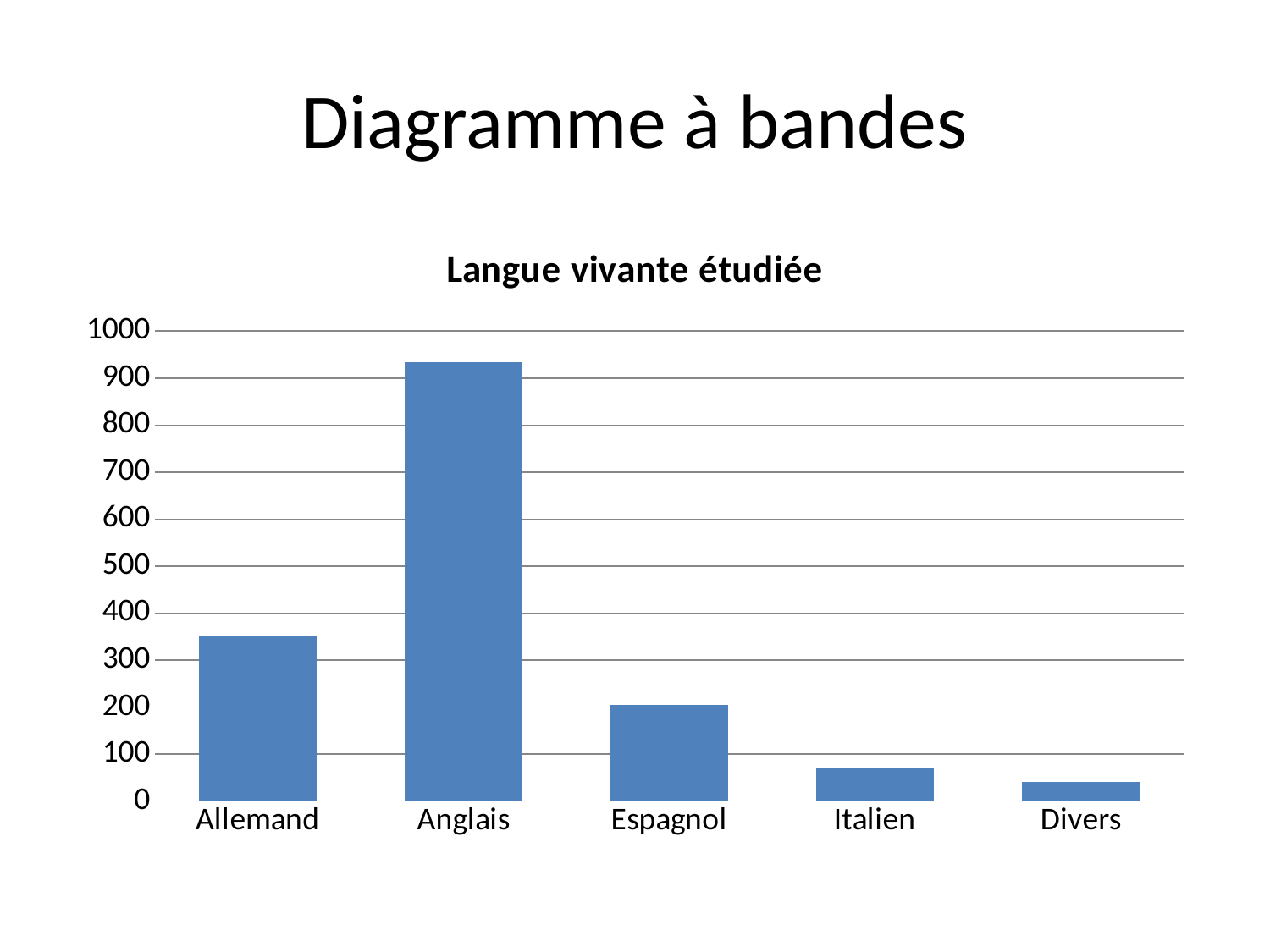
Is the value for Allemand greater or less than 300? greater Which category has the lowest value? Divers What is the title of the chart? Langue vivante étudiée Is the value for Anglais greater or less than 900? greater Is the value for Espagnol greater or less than 300? less Which is larger, the value for Allemand or the value for Espagnol? Allemand Which category has the highest value? Anglais How many categories are shown on the x axis of the chart? 5 Which is larger, the value for Italien or the value for Divers? Italien What kind of chart is shown on the slide? bar chart